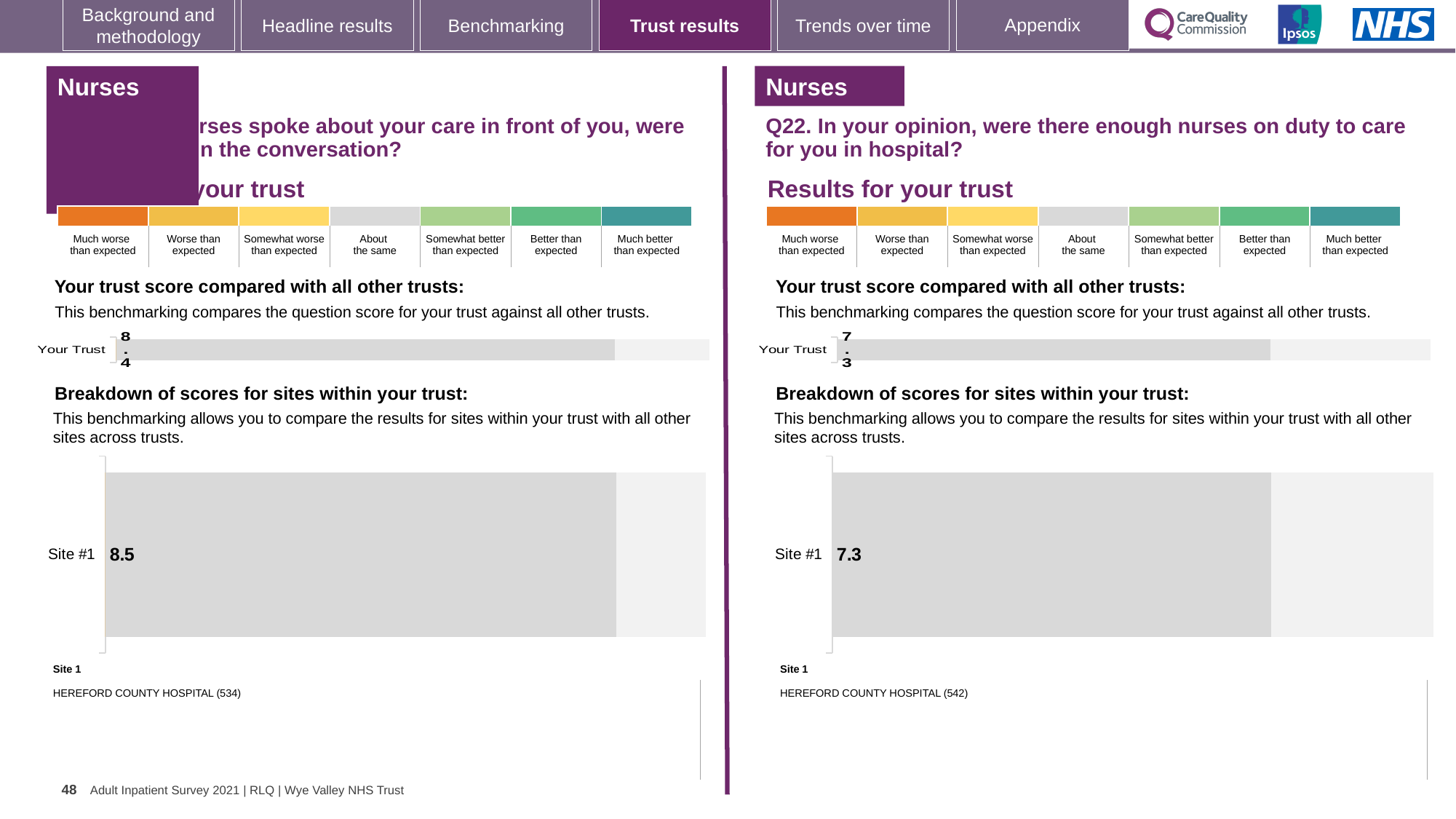
How many sites are plotted in the breakdown of scores chart on the left-hand side of the slide? 1 What is the difference between the Site #1 score on the left-hand side of the slide (8.5) and the Site #1 score on the right-hand side (7.3)? 1.2 How many sites are plotted in the breakdown of scores chart on the right-hand side of the slide (Q22)? 1 Which site name is listed under Site 1 for the breakdown chart on the left-hand side of the slide? HEREFORD COUNTY HOSPITAL (534) Which is larger: the Site #1 score on the left-hand side of the slide or the Site #1 score on the right-hand side (Q22)? Left-hand side (8.5) Which site name is listed under Site 1 for the breakdown chart on the right-hand side of the slide (Q22)? HEREFORD COUNTY HOSPITAL (542) On the right-hand side of the slide (Q22), what is the value shown for Your Trust in the trust score chart? 7.3 On the left-hand side of the slide, what score is shown for Site #1 in the breakdown of scores chart? 8.5 On the right-hand side of the slide (Q22), what score is shown for Site #1 in the breakdown of scores chart? 7.3 What type of chart is used to show the Site #1 score on the right-hand side of the slide (Q22)? Bar chart What is the difference between the Your Trust score on the left-hand side of the slide (8.4) and the Your Trust score on the right-hand side (7.3)? 1.1 On the left-hand side of the slide, what is the value shown for Your Trust in the trust score chart? 8.4